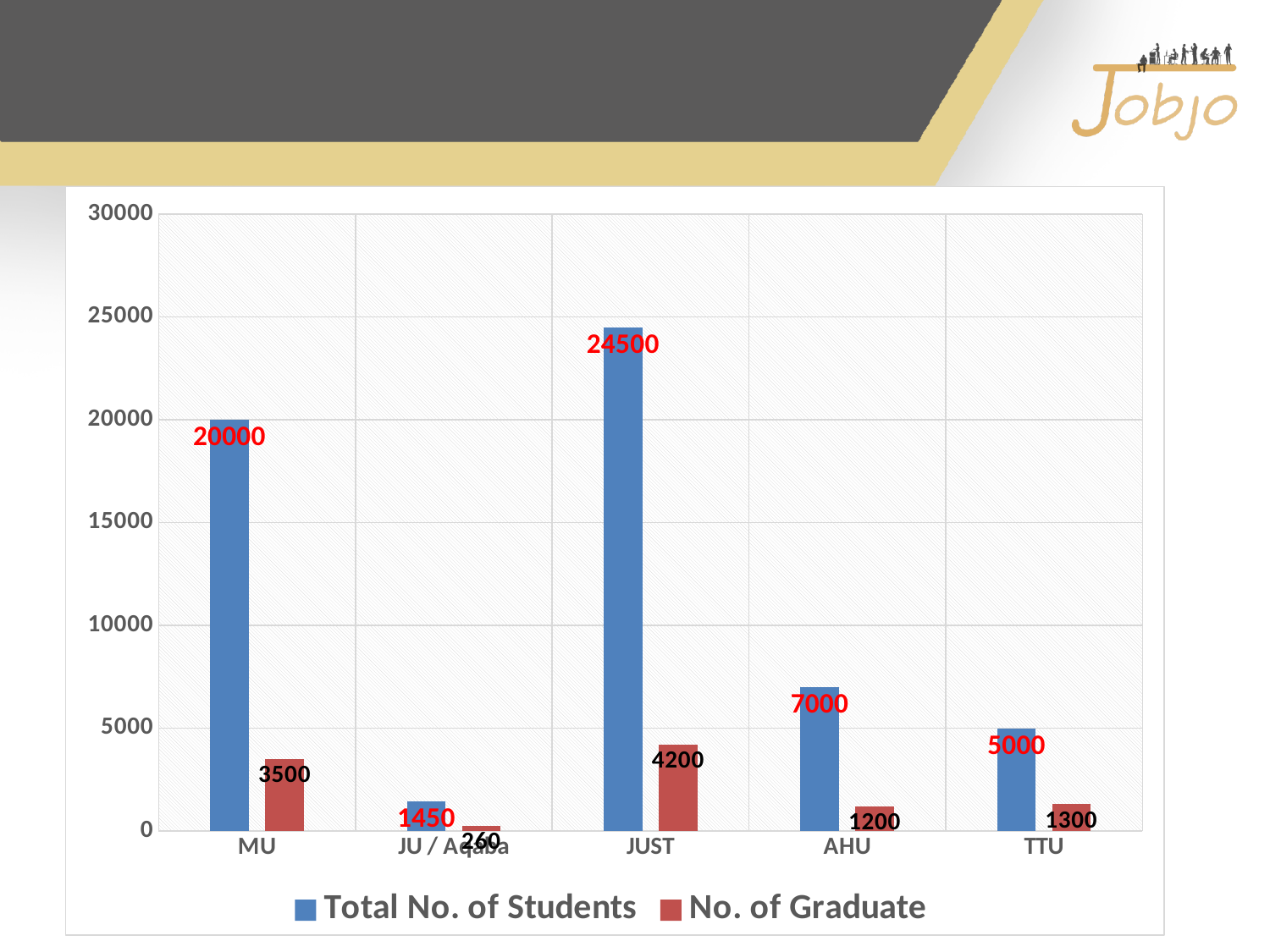
Is the Total No. of Students for TTU greater or less than 10000? less What is the Total No. of Students for JUST? 24500 What is the No. of Graduate for MU? 3500 How many series does the legend list? 2 What is the No. of Graduate for TTU? 1300 What is the Total No. of Students for AHU? 7000 Which is larger, the No. of Graduate for JUST or for MU? JUST Which category has the highest Total No. of Students? JUST What kind of chart is shown on the slide? bar chart What is the difference between the Total No. of Students for JUST and for MU? 4500 Which category has the lowest No. of Graduate? JU / Aqaba How many categories are shown on the x axis? 5